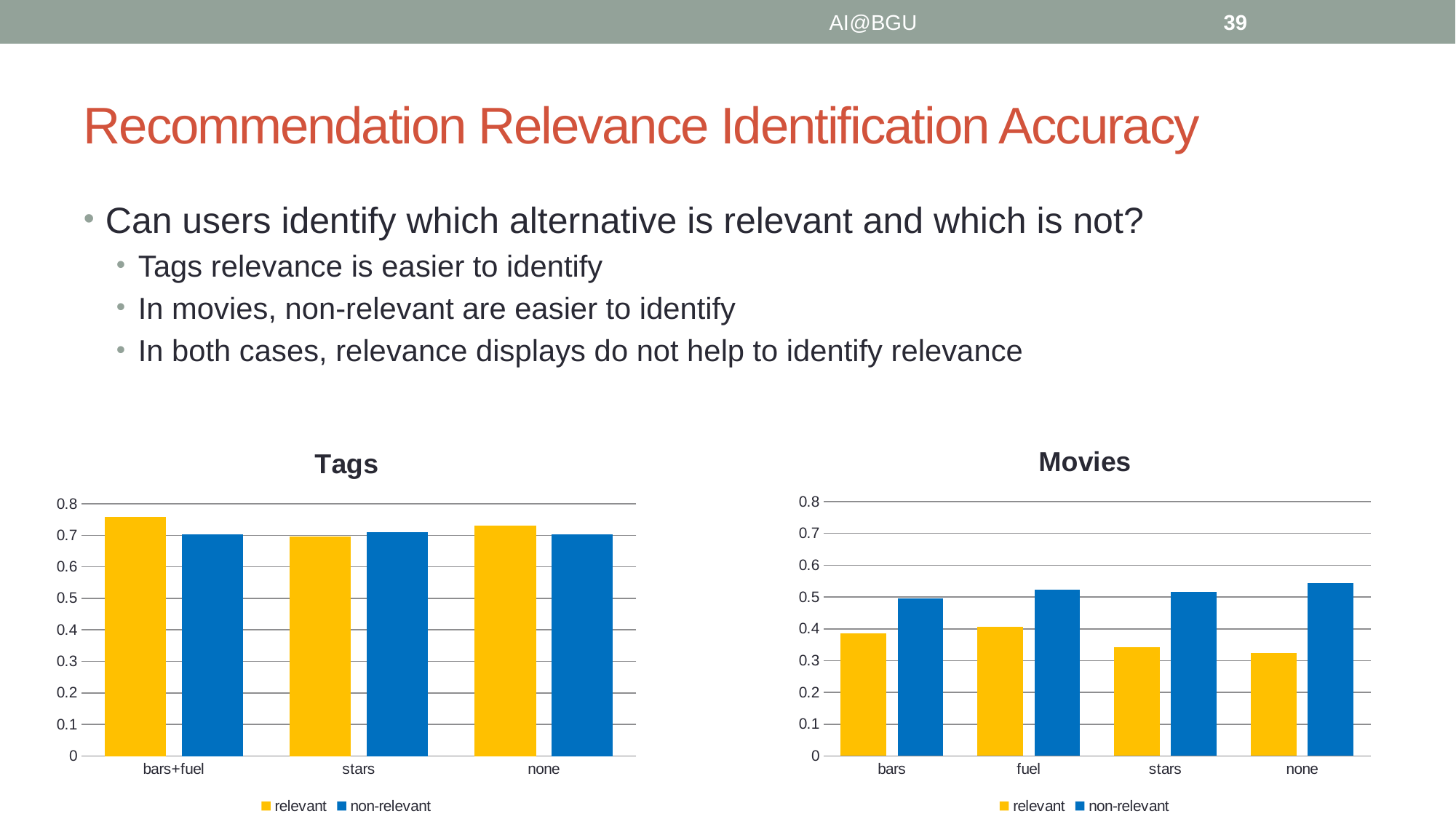
In the Tags chart, which category has the lowest relevant value? stars In the Tags chart, which category has the highest relevant value? bars+fuel In the Movies chart, for bars, which is larger: relevant or non-relevant? non-relevant In the Movies chart, is the relevant value for stars greater or less than 0.4? less In the Tags chart, for bars+fuel, which is larger: relevant or non-relevant? relevant What kind of chart is the Tags chart? bar chart In the Tags chart, is the relevant value for bars+fuel greater or less than 0.7? greater In the Movies chart, is the non-relevant value for none greater or less than 0.5? greater How many series does the legend of the Tags chart list? 2 How many categories are shown on the x axis of the Movies chart? 4 In the Movies chart, which category has the highest non-relevant value? none What are the two series named in the legend of the Movies chart? relevant and non-relevant